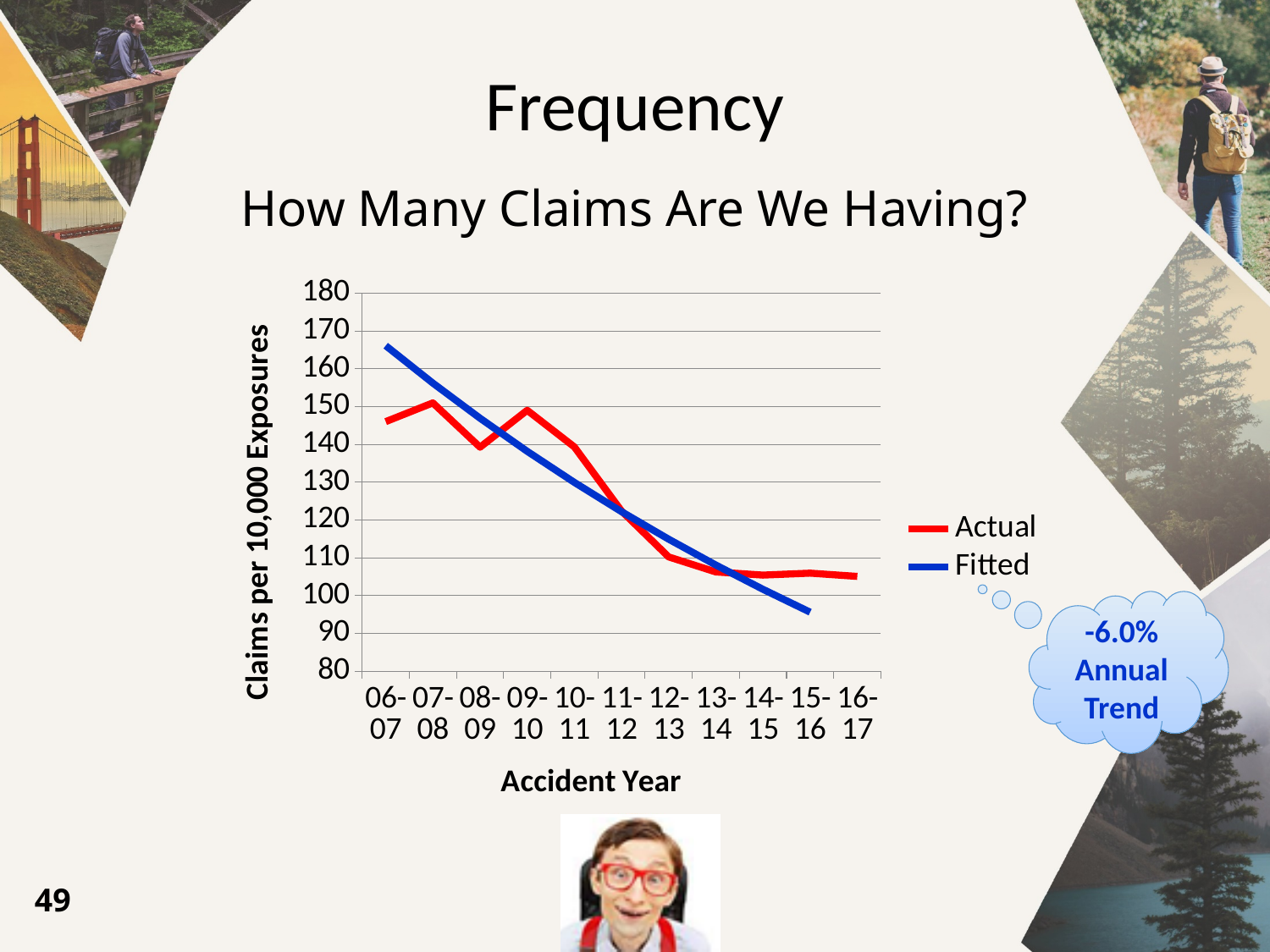
Is the Actual value for 06-07 greater or less than 140? greater For accident year 06-07, which is larger, the Actual value or the Fitted value? Fitted Is the Fitted value for 15-16 greater or less than 100? less How many accident years are shown on the x axis? 11 How many series does the legend list? 2 Is the Actual value for 12-13 greater or less than 120? less For accident year 09-10, which is larger, the Actual value or the Fitted value? Actual Do the Actual values generally rise or fall across the accident years? Fall Which accident year has the highest Fitted value? 06-07 What kind of chart is shown on the slide? Line chart What is the title of the y axis? Claims per 10,000 Exposures Which accident year has the lowest Fitted value? 15-16